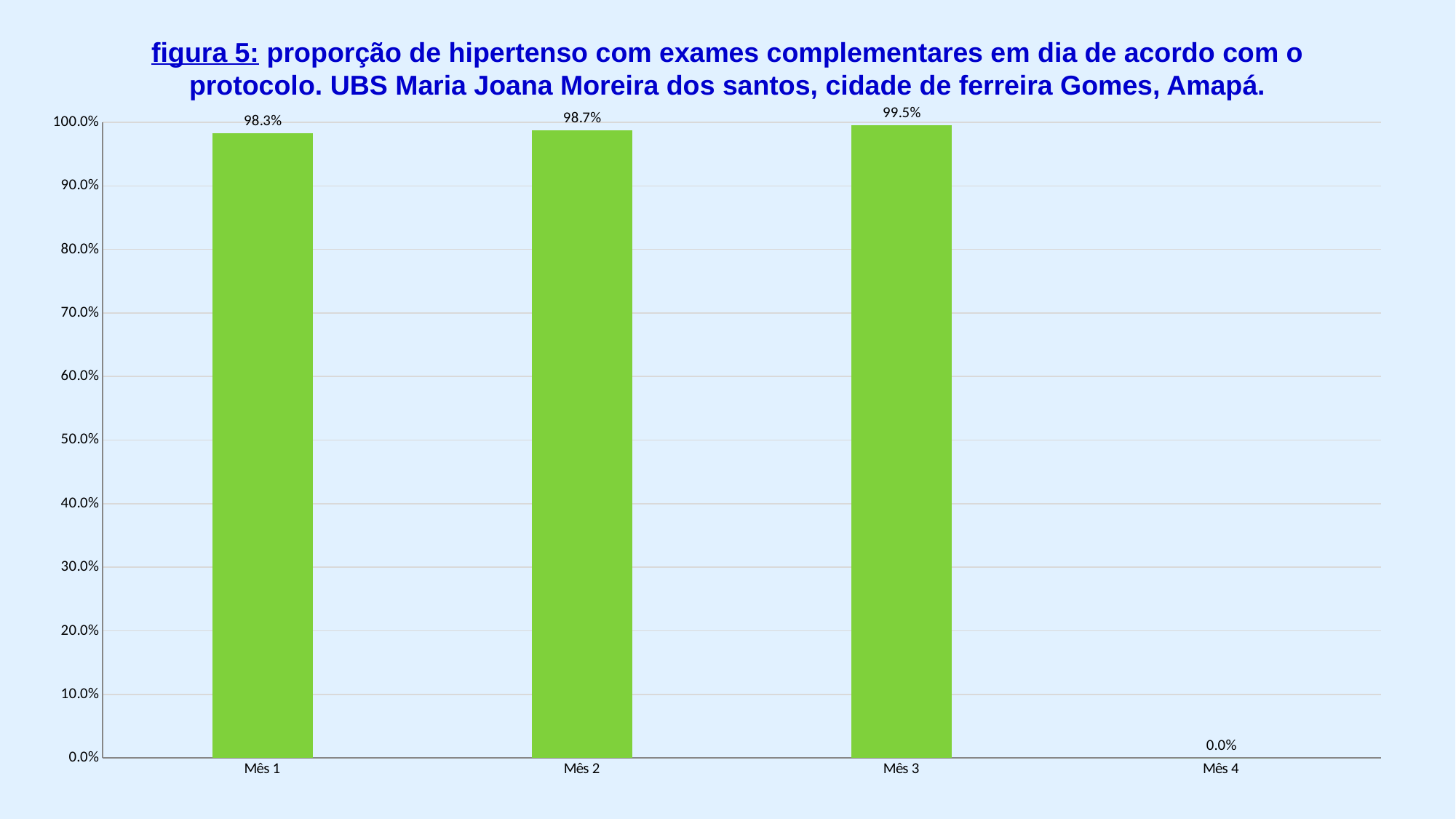
How many months are shown on the x axis? 4 What is the value for Mês 4? 0.0% What is the value for Mês 1? 98.3% What kind of chart is shown on the slide? bar chart Which month has the highest value? Mês 3 What is the difference between the values for Mês 3 and Mês 1? 1.2% What is the value for Mês 2? 98.7% Which month has the lowest value? Mês 4 Which is larger, the value for Mês 2 or the value for Mês 4? Mês 2 What colour are the bars in the chart? green Is the value for Mês 2 greater or less than 90.0%? greater What is the value for Mês 3? 99.5%